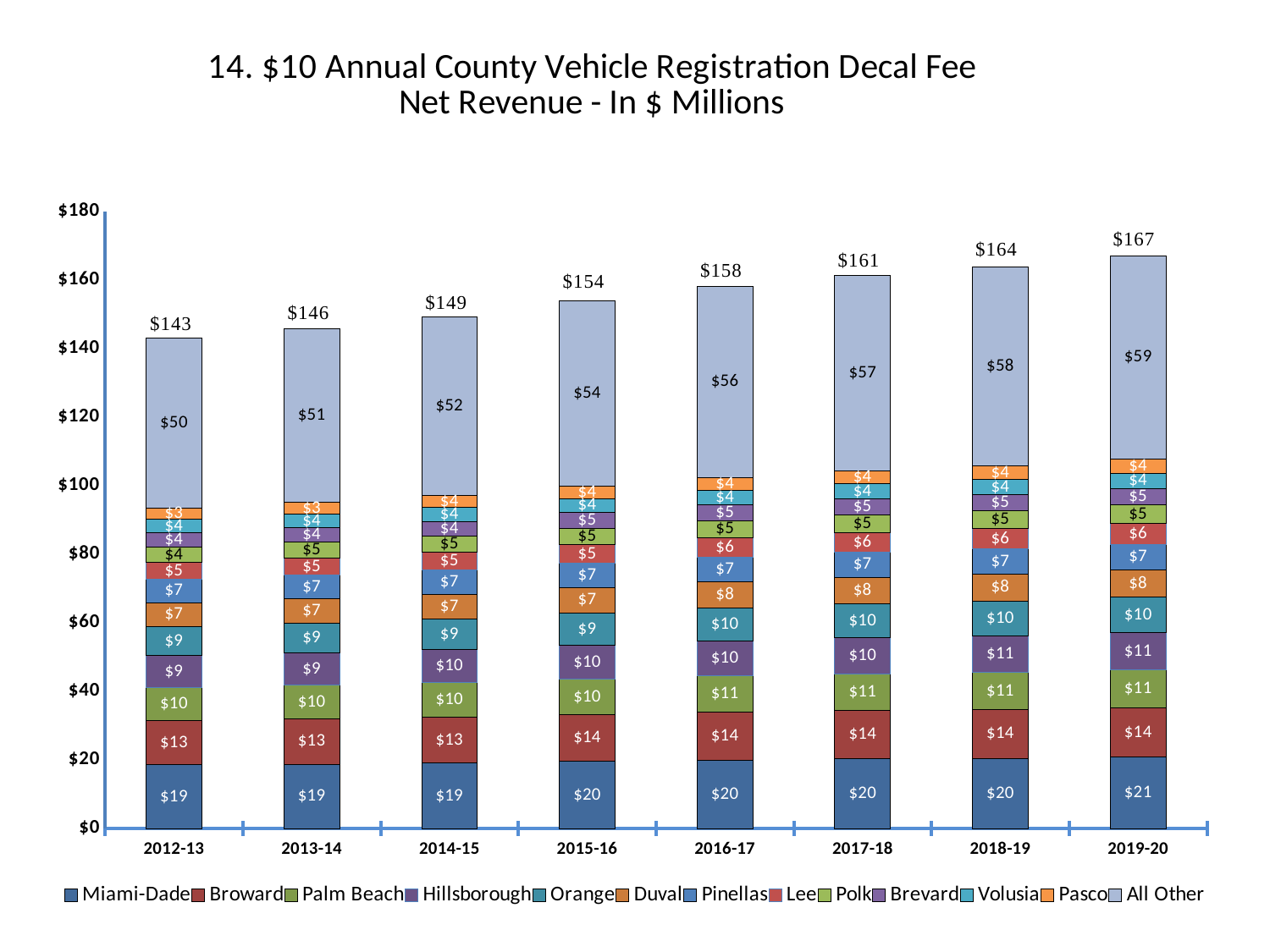
What is the value for Orange in 2017-18? $10 How many fiscal years are shown along the x axis? 8 Which fiscal year has the lowest total net revenue? 2012-13 What kind of chart is shown on the slide? Stacked bar chart What is the value for Miami-Dade in 2012-13? $19 Which fiscal year has the highest total net revenue? 2019-20 What is the total net revenue for 2019-20? $167 How many series does the legend list? 13 What is the difference between the total for 2019-20 and the total for 2012-13? $24 In 2015-16, which is larger: the value for Broward or the value for Palm Beach? Broward Do the total net revenues rise or fall from 2012-13 to 2019-20? Rise What is the value for All Other in 2016-17? $56